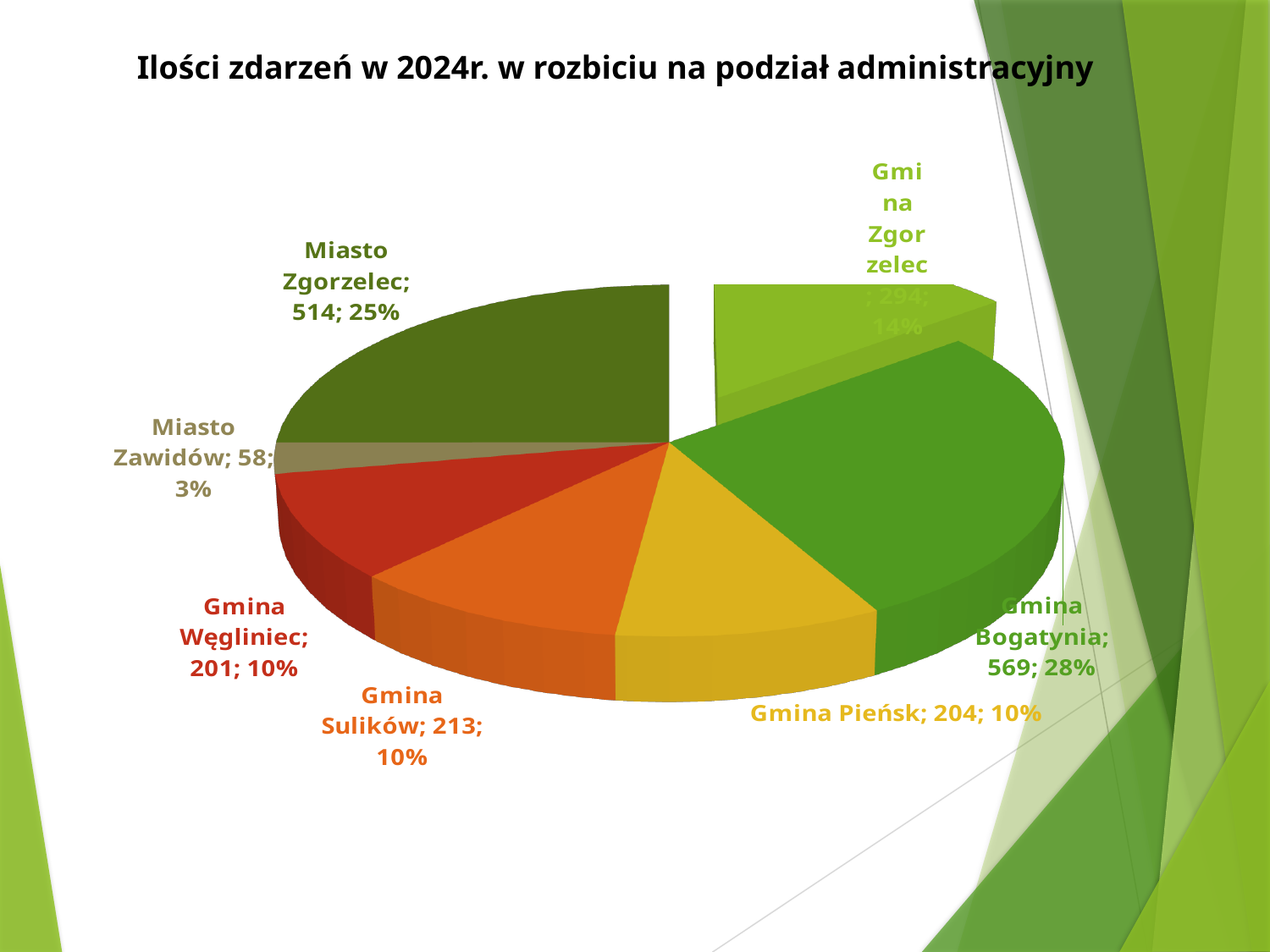
What kind of chart is shown on the slide? pie chart Which category has the largest slice of the pie? Gmina Bogatynia What is the difference between the values for Gmina Bogatynia and Miasto Zgorzelec? 55 Which has a larger value, Gmina Sulików or Gmina Węgliniec? Gmina Sulików Which category has the smallest slice of the pie? Miasto Zawidów What share of the pie does Gmina Pieńsk have? 10% What is the title of the chart? Ilości zdarzeń w 2024r. w rozbiciu na podział administracyjny How many events are shown for Gmina Bogatynia? 569 What share of the pie does Miasto Zgorzelec have? 25% How many categories (slices) does the pie chart have? 7 What is the difference between the values for Gmina Sulików and Gmina Pieńsk? 9 How many events are shown for Miasto Zawidów? 58